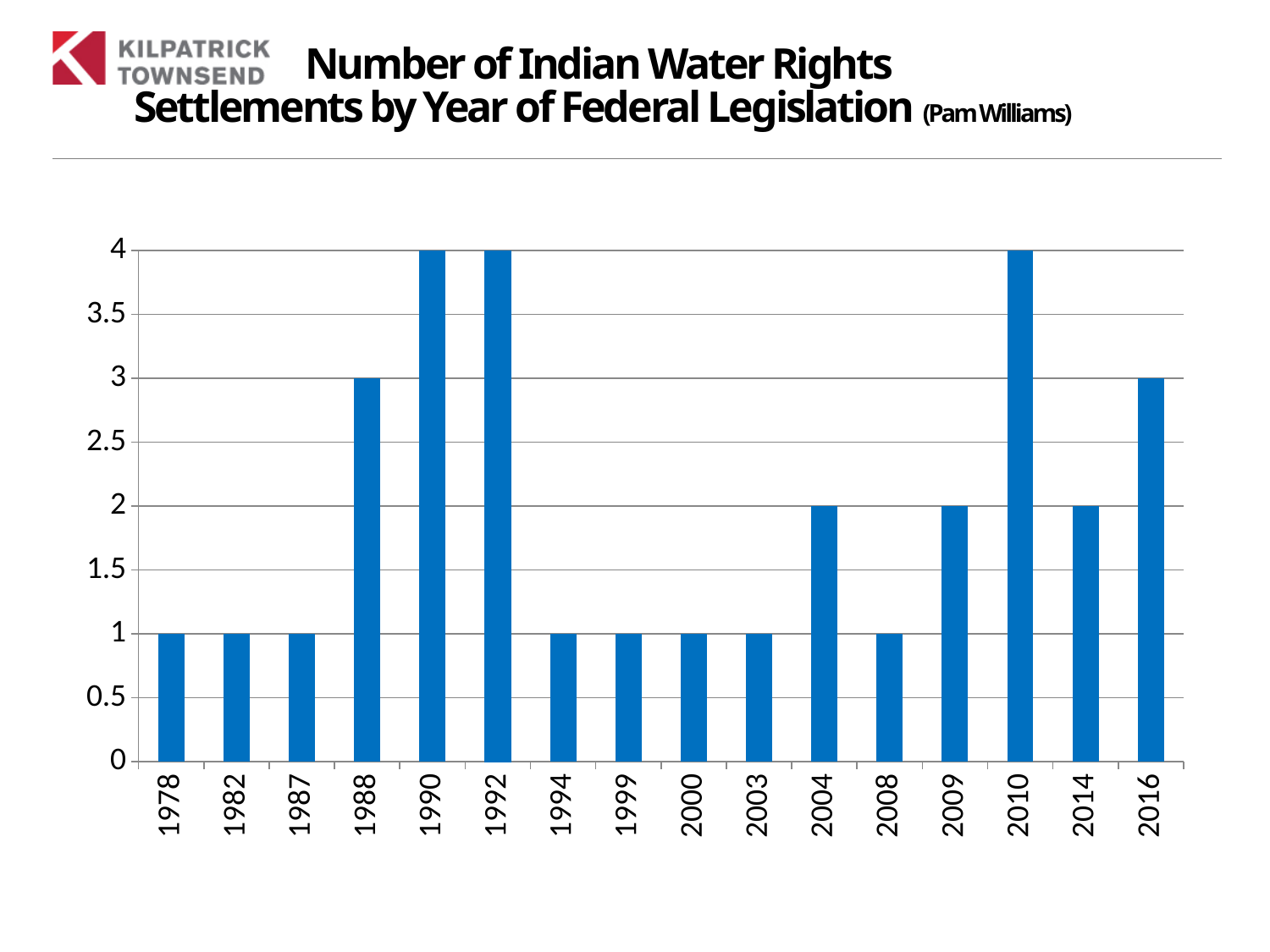
What is the difference between the values for 2010 and 2014? 2 What is the title of the chart? Number of Indian Water Rights Settlements by Year of Federal Legislation What is the value for 1988? 3 What is the value for 1978? 1 What is the value for 2016? 3 What is the value for 2010? 4 How many years are shown on the x axis? 16 What is the highest value shown on the chart? 4 What is the difference between the values for 1990 and 1988? 1 Which has a larger value, 1988 or 2004? 1988 What kind of chart is shown on the slide? bar chart What is the value for 2004? 2